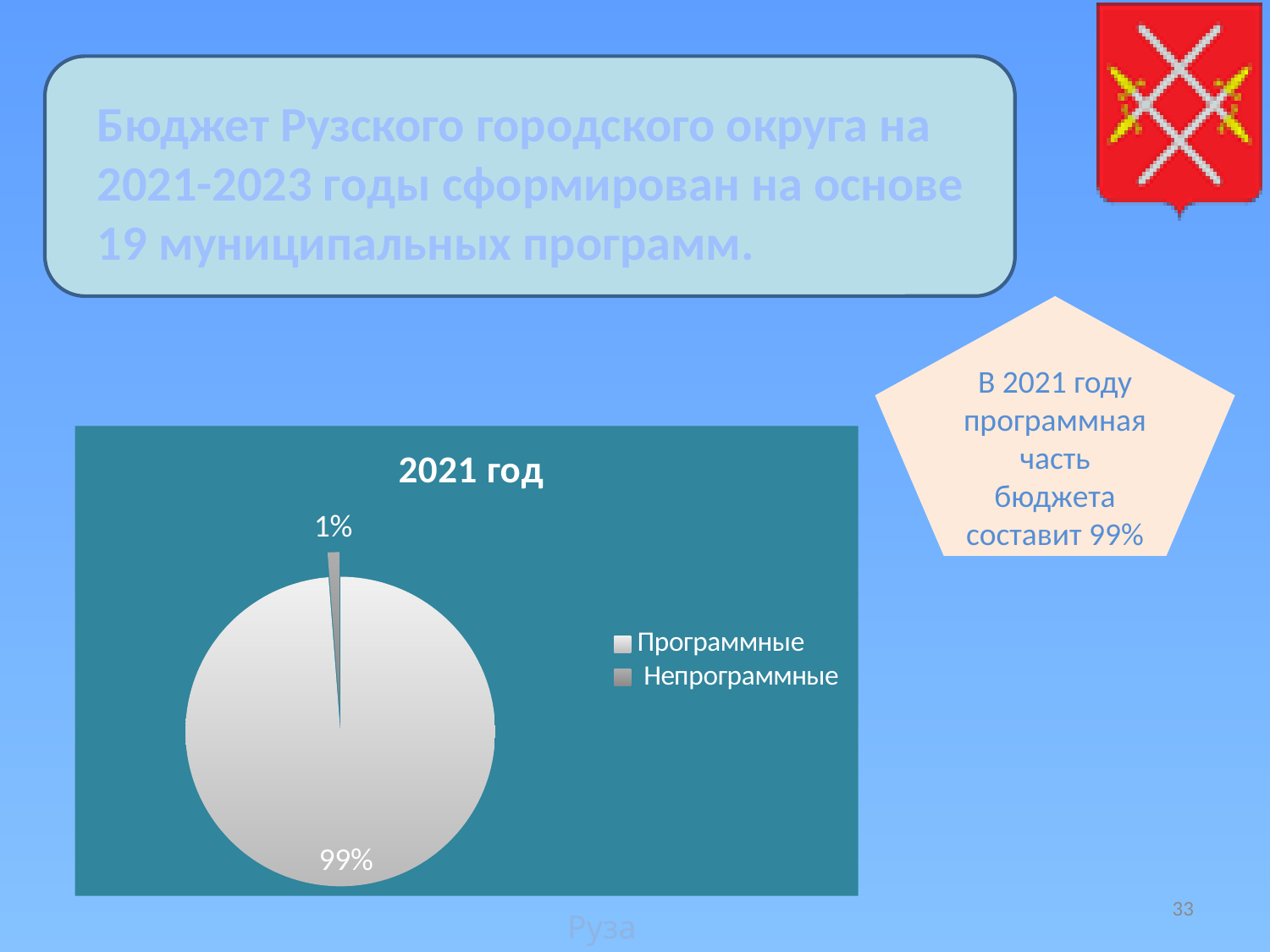
What is the difference in percentage points between the Программные and Непрограммные slices? 98 percentage points Which slice of the pie is the smallest? Непрограммные What share of the pie is labelled Программные? 99% What is the title of the chart? 2021 год What kind of chart is shown on the slide? pie chart How many entries does the legend list? 2 How many slices does the pie chart have? 2 Which is larger, the Программные slice or the Непрограммные slice? Программные Which legend entry is shown in the darker grey colour? Непрограммные What share of the pie is labelled Непрограммные? 1% Which slice of the pie is the largest? Программные What is the total of the two slices shown in the pie chart? 100%